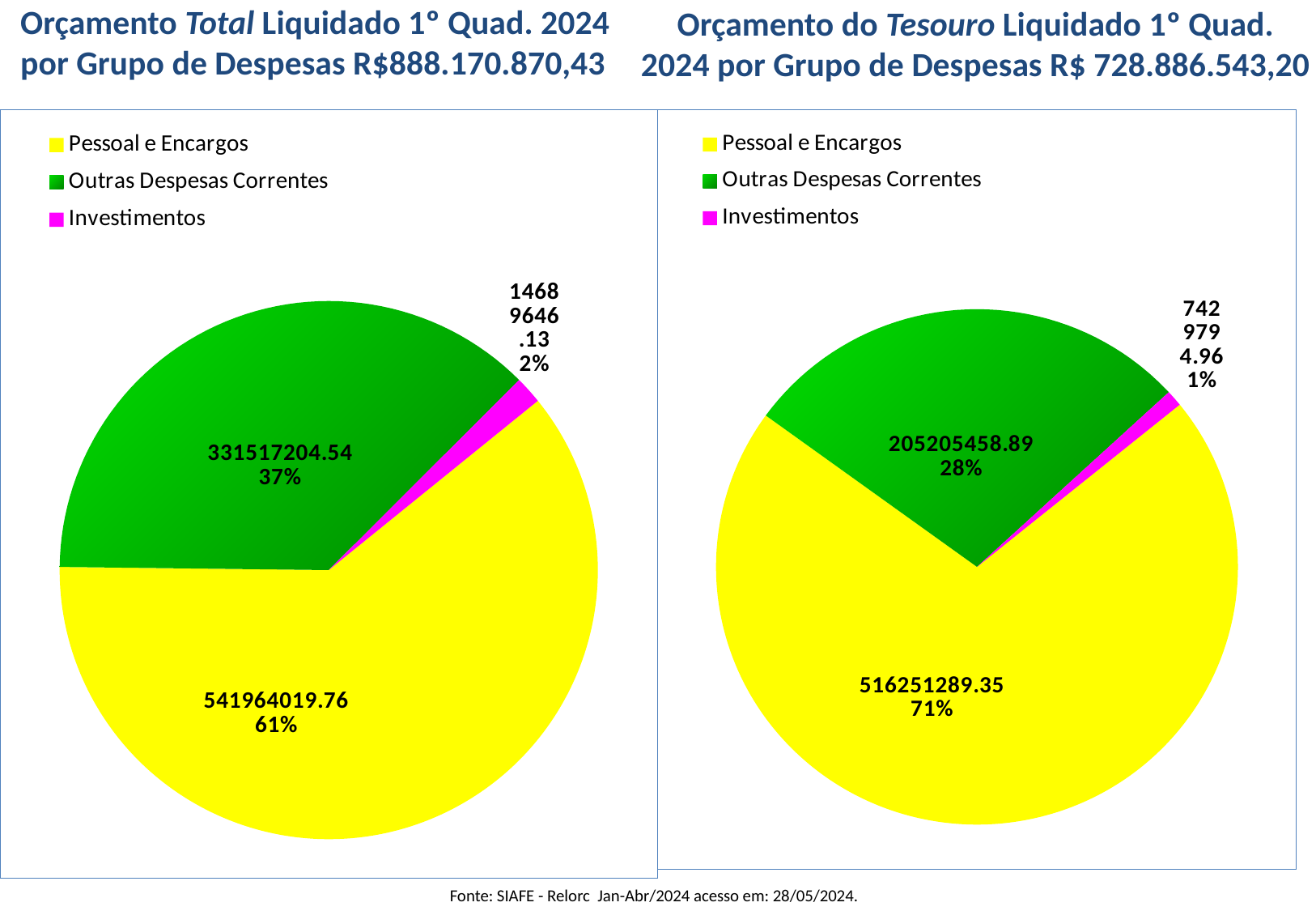
How many categories does the legend of the right chart (Orçamento do Tesouro) list? 3 In the right chart (Orçamento do Tesouro), what share of the pie is Outras Despesas Correntes? 28% In the left chart (Orçamento Total), what share of the pie is Pessoal e Encargos? 61% In the left chart (Orçamento Total), what is the value for Outras Despesas Correntes? 331517204.54 What kind of chart is the left chart, 'Orçamento Total Liquidado 1° Quad. 2024 por Grupo de Despesas'? Pie chart In the right chart (Orçamento do Tesouro), which category has the smallest slice? Investimentos In the left chart (Orçamento Total), what share of the pie is Investimentos? 2% In the right chart (Orçamento do Tesouro), what is the value for Pessoal e Encargos? 516251289.35 In the left chart (Orçamento Total), what is the value for Pessoal e Encargos? 541964019.76 In the left chart (Orçamento Total), which category has the largest slice? Pessoal e Encargos In the right chart (Orçamento do Tesouro), what is the value for Outras Despesas Correntes? 205205458.89 In the left chart (Orçamento Total), which is larger: Outras Despesas Correntes or Investimentos? Outras Despesas Correntes